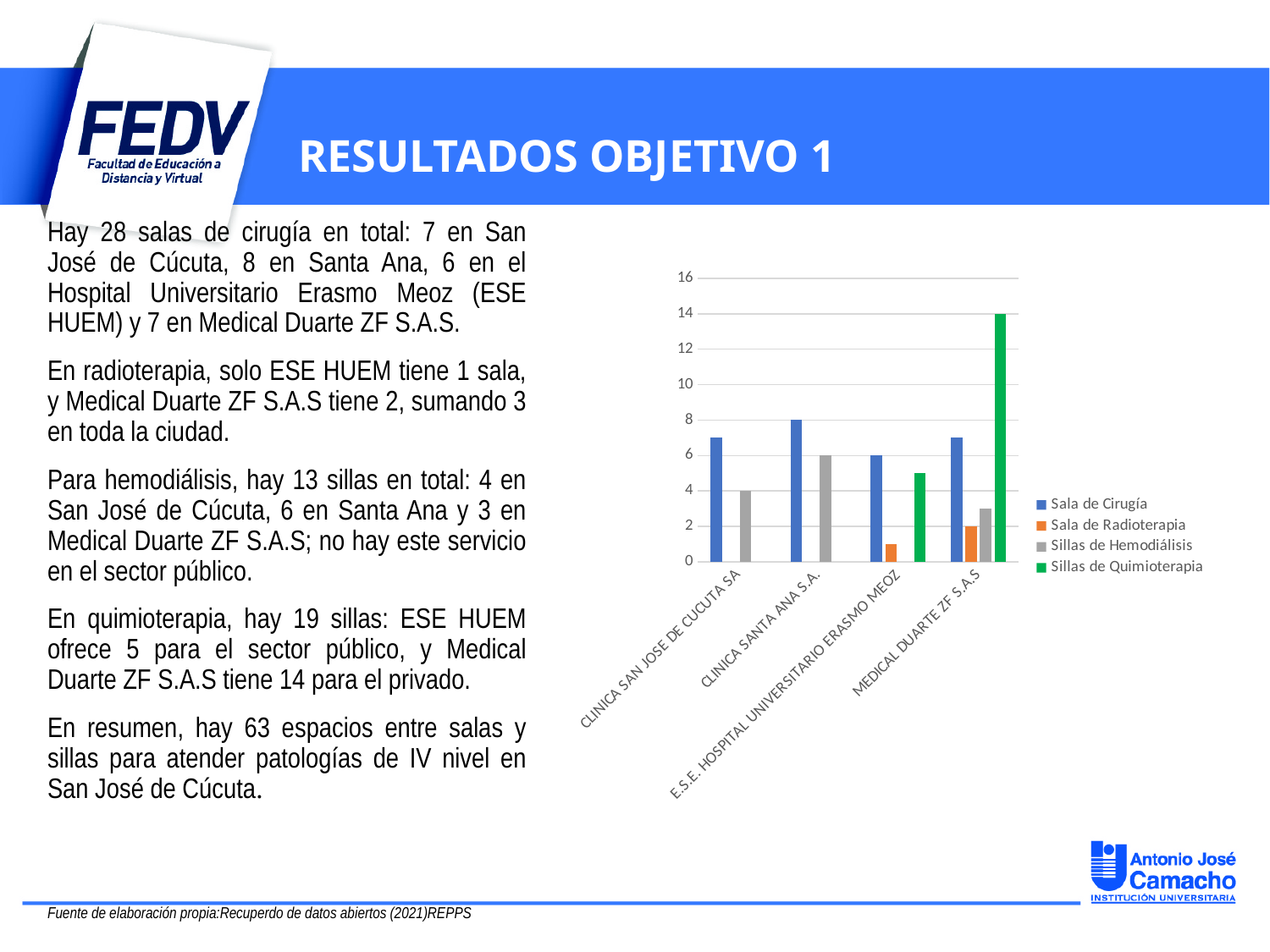
What is the value of Sillas de Quimioterapia for Medical Duarte ZF S.A.S? 14 Is the value for Sala de Cirugía at Medical Duarte ZF S.A.S greater or less than 6? greater What kind of chart is shown on the slide? Bar chart How many institutions (categories) are shown on the x axis of the chart? 4 What colour represents Sillas de Quimioterapia in the legend? Green How many series does the chart's legend list? 4 Which institution has the highest value for Sala de Cirugía? Clinica Santa Ana S.A. Which series and institution has the tallest bar in the chart? Sillas de Quimioterapia, Medical Duarte ZF S.A.S What is the value of Sillas de Hemodiálisis for Clinica San José de Cúcuta SA? 4 What is the value of Sala de Cirugía for Clinica Santa Ana S.A.? 8 Which has more Sillas de Hemodiálisis, Clinica Santa Ana S.A. or Clinica San José de Cúcuta SA? Clinica Santa Ana S.A. Is the value for Sillas de Quimioterapia at E.S.E. Hospital Universitario Erasmo Meoz greater or less than 4? greater